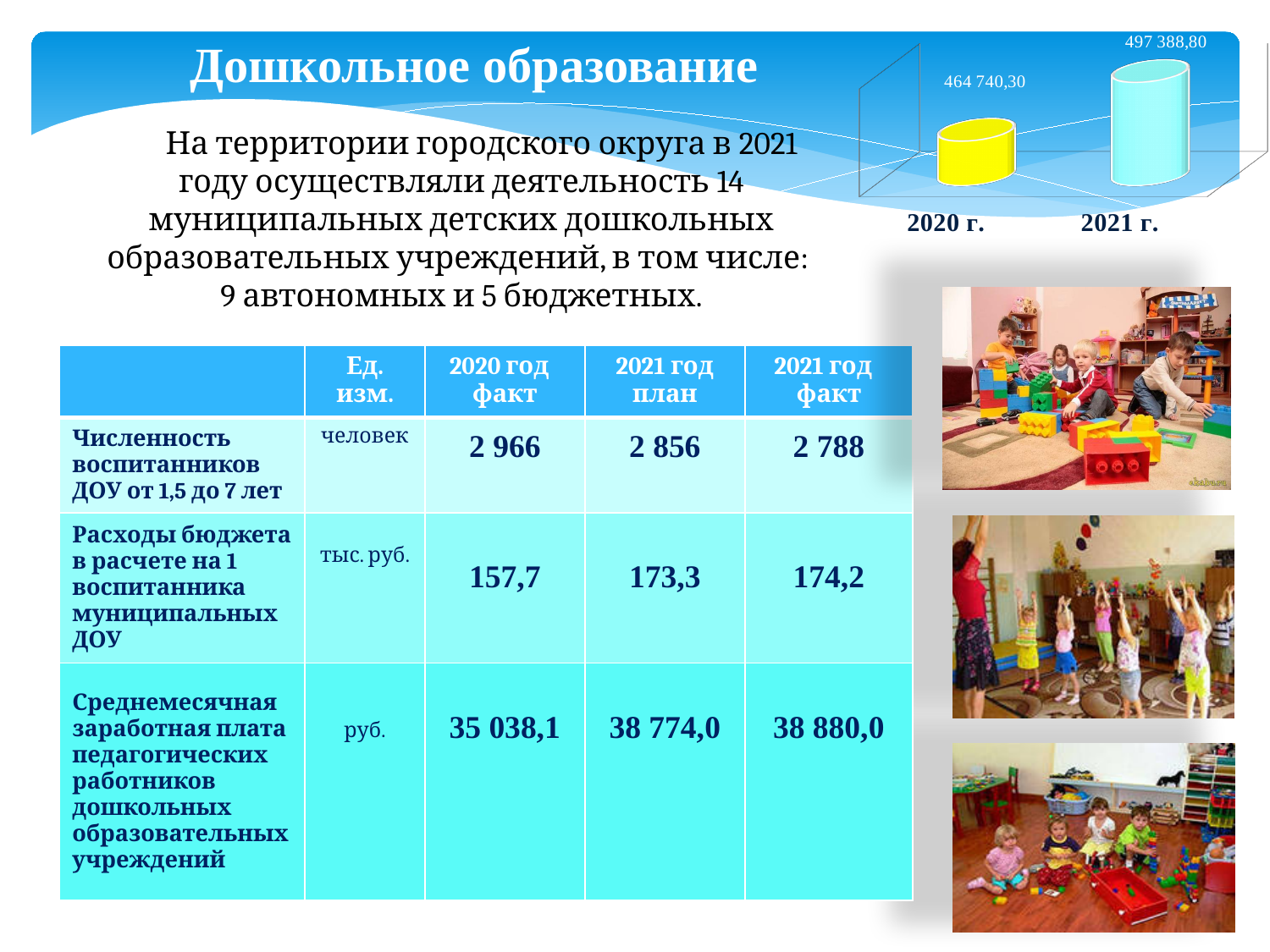
Which year has the higher value in the chart? 2021 г. What is the value shown for 2020 г. in the chart? 464 740,30 Does the value rise or fall from 2020 г. to 2021 г. in the chart? rise What kind of chart is shown in the top right of the slide? bar chart Is the value for 2021 г. larger or smaller than the value for 2020 г. in the chart? larger How many categories (years) are plotted in the chart? 2 What is the value shown for 2021 г. in the chart? 497 388,80 What colour is the bar for 2020 г. in the chart? yellow By how much does the value for 2021 г. exceed the value for 2020 г. in the chart? 32 648,50 Which year has the lower value in the chart? 2020 г. What colour is the bar for 2021 г. in the chart? light blue